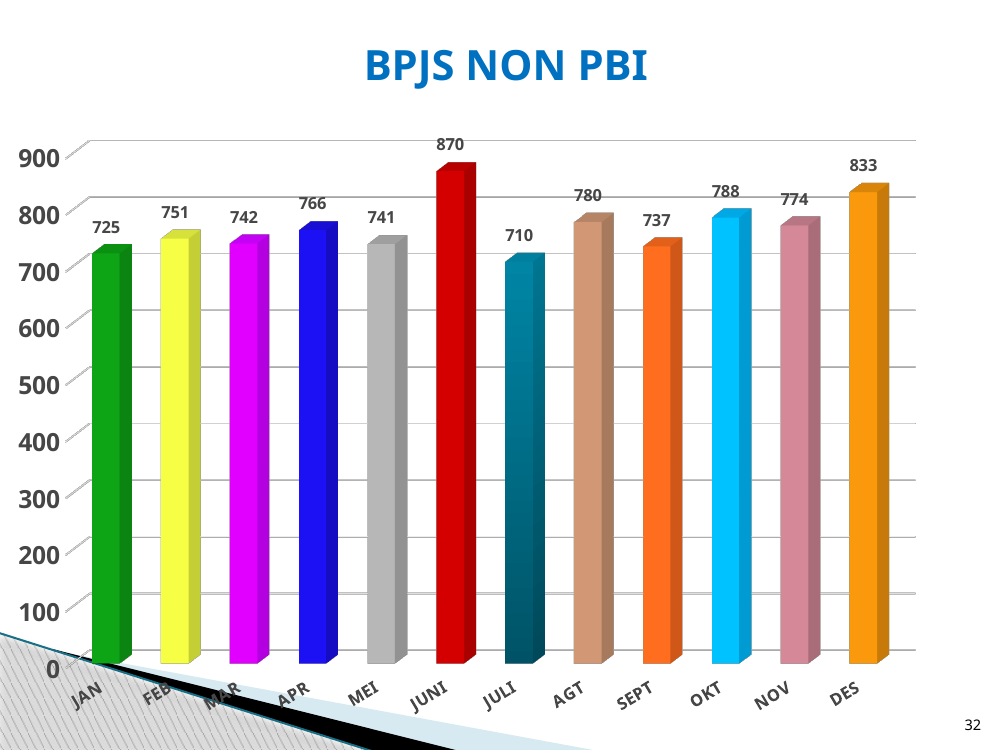
What is the value for JUNI? 870 What is the difference between the values for JUNI and JULI? 160 Is the value for SEPT greater or less than 800? less How many months are shown on the x axis? 12 What is the value for DES? 833 What kind of chart is shown on the slide? bar chart What is the difference between the values for DES and NOV? 59 What is the title of the chart? BPJS NON PBI Which month has the highest value? JUNI What is the value for JAN? 725 Which month has the lowest value? JULI Which is larger, the value for OKT or the value for NOV? OKT